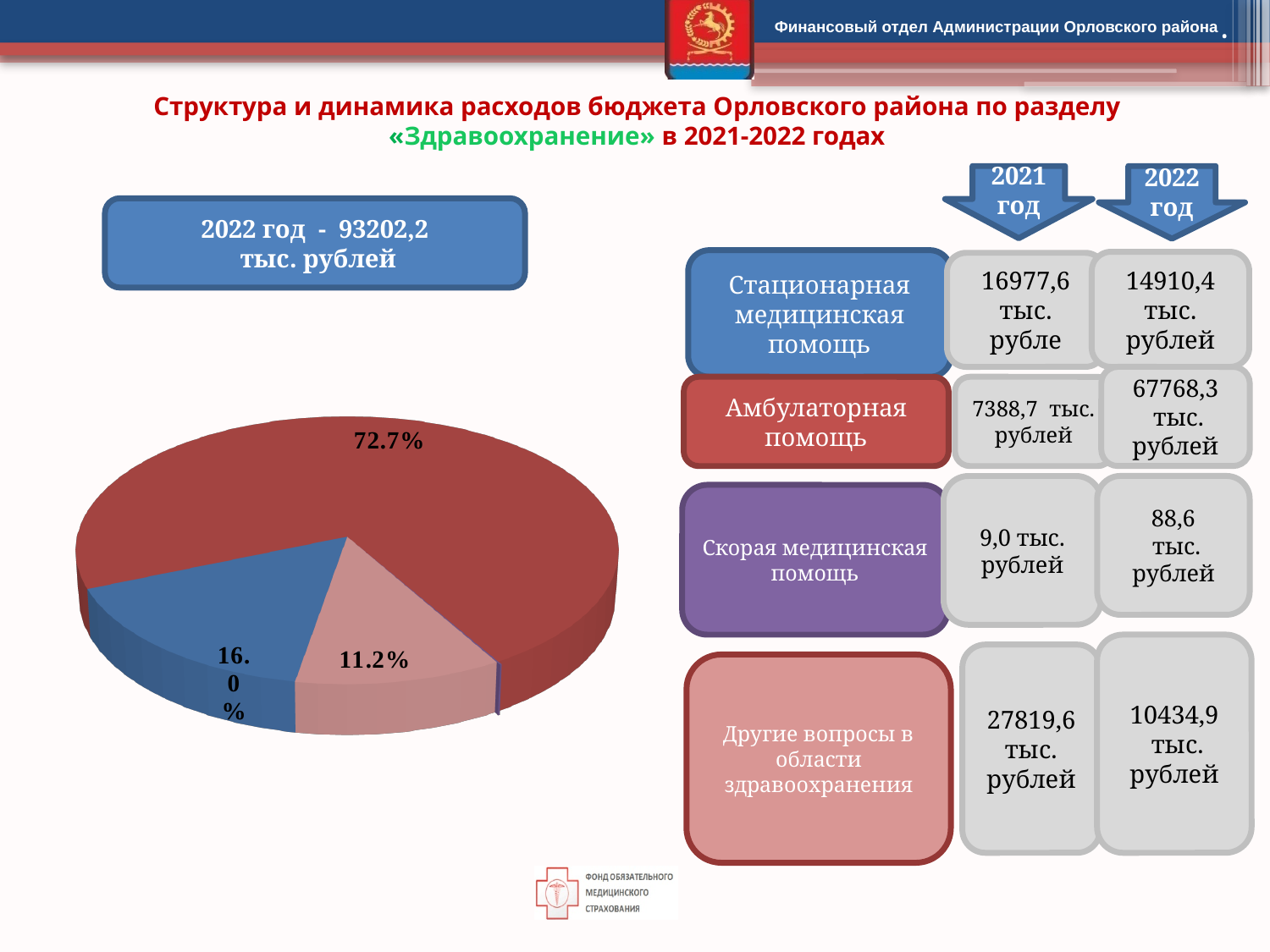
What kind of chart is shown on the left of the slide? pie chart How many slices of the pie chart have a percentage label? 3 What is the percentage shown for the largest slice of the pie chart? 72.7% What colour is the largest slice of the pie chart? dark red What percentage is shown on the blue slice of the pie chart? 16.0% By how many percentage points does the largest slice (72.7%) exceed the blue slice (16.0%)? 56.7 By how many percentage points does the blue slice (16.0%) exceed the light pink slice (11.2%)? 4.8 What percentage is shown on the dark red slice of the pie chart? 72.7% What is the percentage shown for the smallest labelled slice of the pie chart? 11.2% What percentage is shown on the light pink slice of the pie chart? 11.2% Which slice is larger in the pie chart: the blue slice or the light pink slice? the blue slice Is the share of the largest slice of the pie chart greater or less than 50%? greater